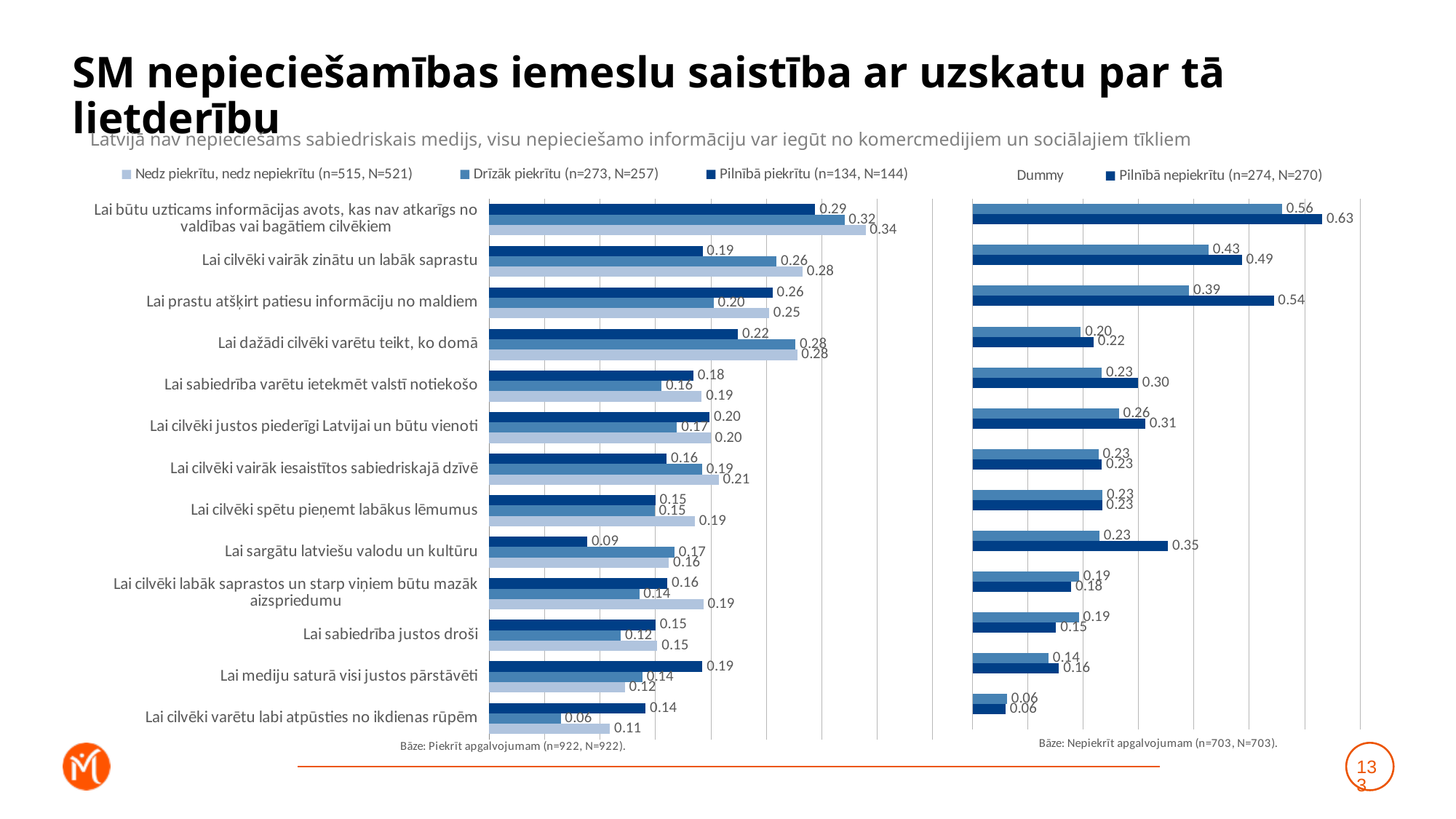
How many categories (statements) are listed in the left chart? 13 In the left chart, what is the difference between 'Drīzāk piekrītu' (0.26) and 'Pilnībā piekrītu' (0.19) for 'Lai cilvēki vairāk zinātu un labāk saprastu'? 0.07 In the left chart, which category has the lowest 'Pilnībā piekrītu' value? Lai sargātu latviešu valodu un kultūru In the left chart, for 'Lai prastu atšķirt patiesu informāciju no maldiem', which is larger: 'Pilnībā piekrītu' or 'Drīzāk piekrītu'? Pilnībā piekrītu In the left chart, what is the value of 'Pilnībā piekrītu' for 'Lai būtu uzticams informācijas avots, kas nav atkarīgs no valdības vai bagātiem cilvēkiem'? 0.29 In the right chart, what is the difference between the two values shown for 'Lai būtu uzticams informācijas avots, kas nav atkarīgs no valdības vai bagātiem cilvēkiem' (0.63 and 0.56)? 0.07 In the right chart, which category has the highest 'Pilnībā nepiekrītu' value? Lai būtu uzticams informācijas avots, kas nav atkarīgs no valdības vai bagātiem cilvēkiem What type of chart is used on this slide? Bar chart In the left chart, what is the value of 'Nedz piekrītu, nedz nepiekrītu' for 'Lai cilvēki varētu labi atpūsties no ikdienas rūpēm'? 0.11 How many series does the legend of the left chart list? 3 In the right chart, what is the value of 'Pilnībā nepiekrītu' for 'Lai prastu atšķirt patiesu informāciju no maldiem'? 0.54